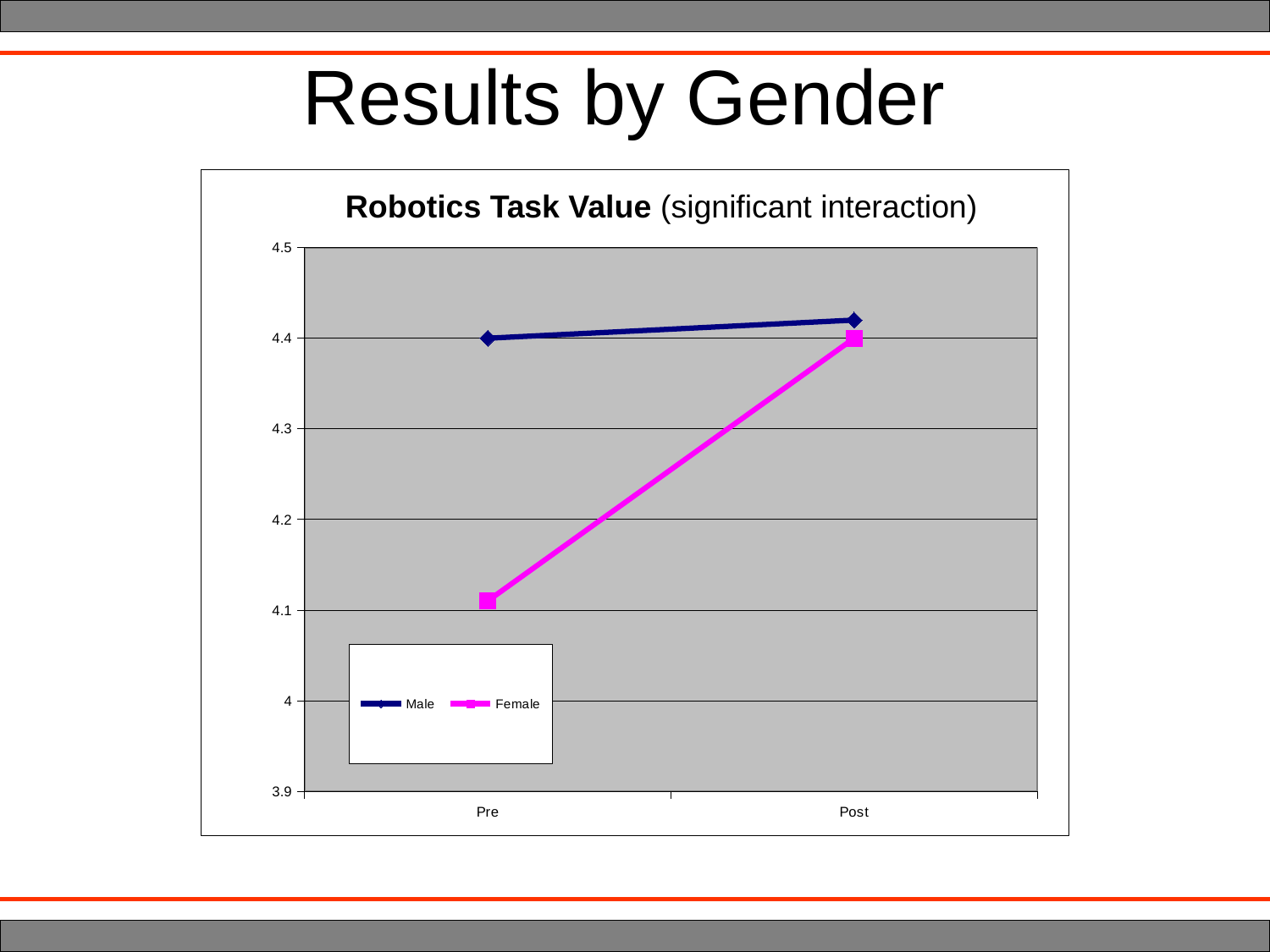
Is the Female value at Pre greater or less than 4.2? less What is the title of the chart? Robotics Task Value (significant interaction) Does the Female line rise or fall from Pre to Post? rise What colour is the Female line? magenta How many points are on the x axis? 2 At Pre, which series has the larger value, Male or Female? Male What kind of chart is shown on the slide? line chart How many series does the legend list? 2 Is the Male value at Post greater or less than 4.4? greater What is the Male value at Pre? 4.4 Which series has the lowest plotted point on the chart? Female